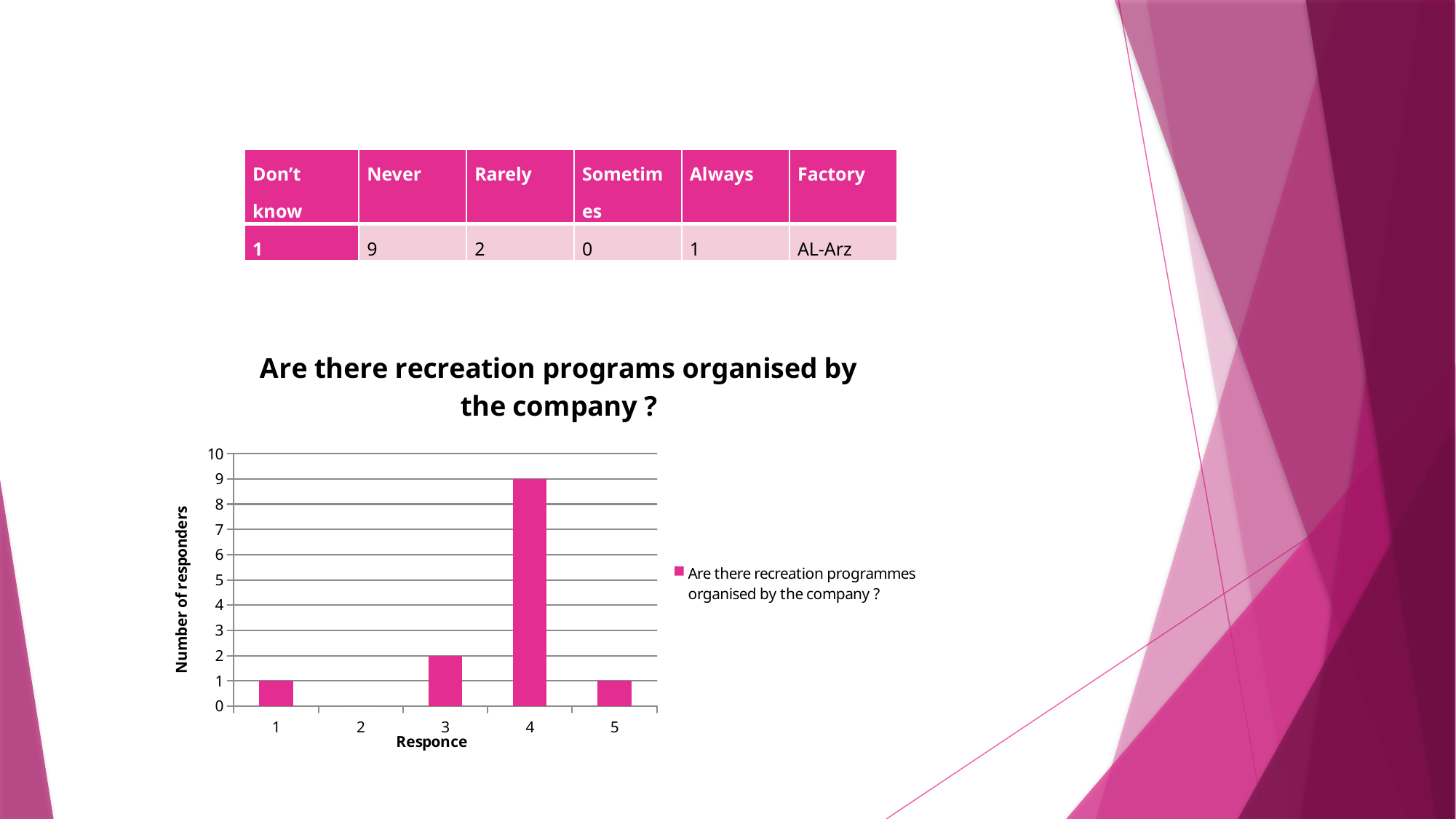
Which response category has the highest number of responders? 4 What kind of chart is shown on the slide? bar chart How many series does the legend list? 1 Which response category has the lowest number of responders? 2 What is the difference between the number of responders for response 4 and response 3? 7 How many categories are shown on the x axis? 5 What is the number of responders for response 1? 1 What is the label of the y axis? Number of responders What is the chart's title? Are there recreation programs organised by the company ? What is the number of responders for response 3? 2 What is the number of responders for response 4? 9 Which has more responders, response 3 or response 5? 3